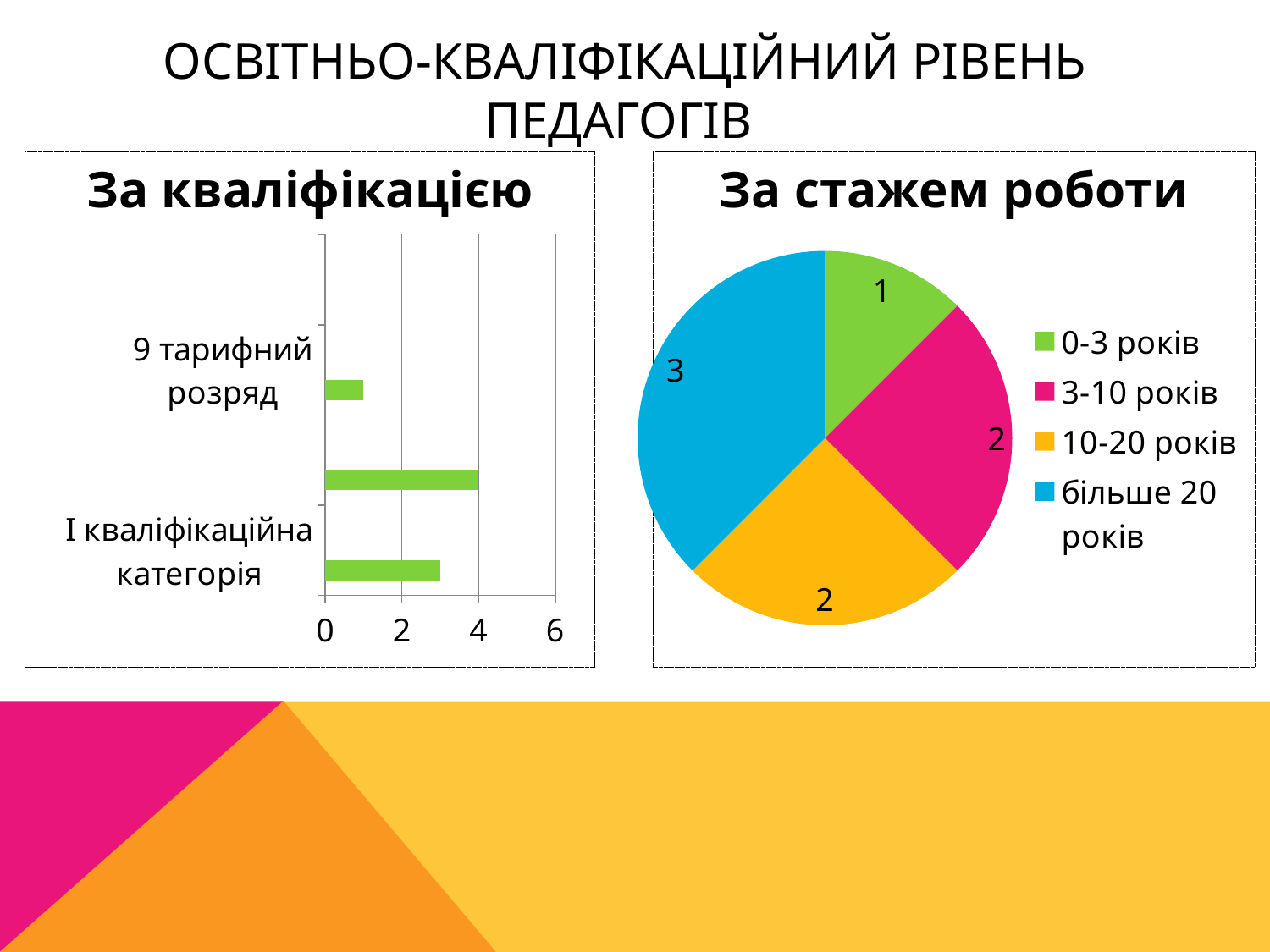
In the 'За стажем роботи' chart, what is the value for '3-10 років'? 2 In the 'За стажем роботи' chart, what is the value for 'більше 20 років'? 3 In the 'За стажем роботи' chart, what is the value for '0-3 років'? 1 In the 'За кваліфікацією' chart, is the value for '9 тарифний розряд' greater or less than 2? less What kind of chart is the 'За кваліфікацією' chart? bar chart In the 'За стажем роботи' chart, which category has the largest value? більше 20 років What kind of chart is the 'За стажем роботи' chart? pie chart In the 'За стажем роботи' chart, what share of the total does 'більше 20 років' represent? 37.5% In the 'За кваліфікацією' chart, is the value for 'І кваліфікаційна категорія' greater or less than 2? greater In the 'За стажем роботи' chart, which category has the smallest value? 0-3 років In the 'За стажем роботи' chart, what is the difference between 'більше 20 років' and '0-3 років'? 2 How many entries does the legend of the 'За стажем роботи' chart list? 4